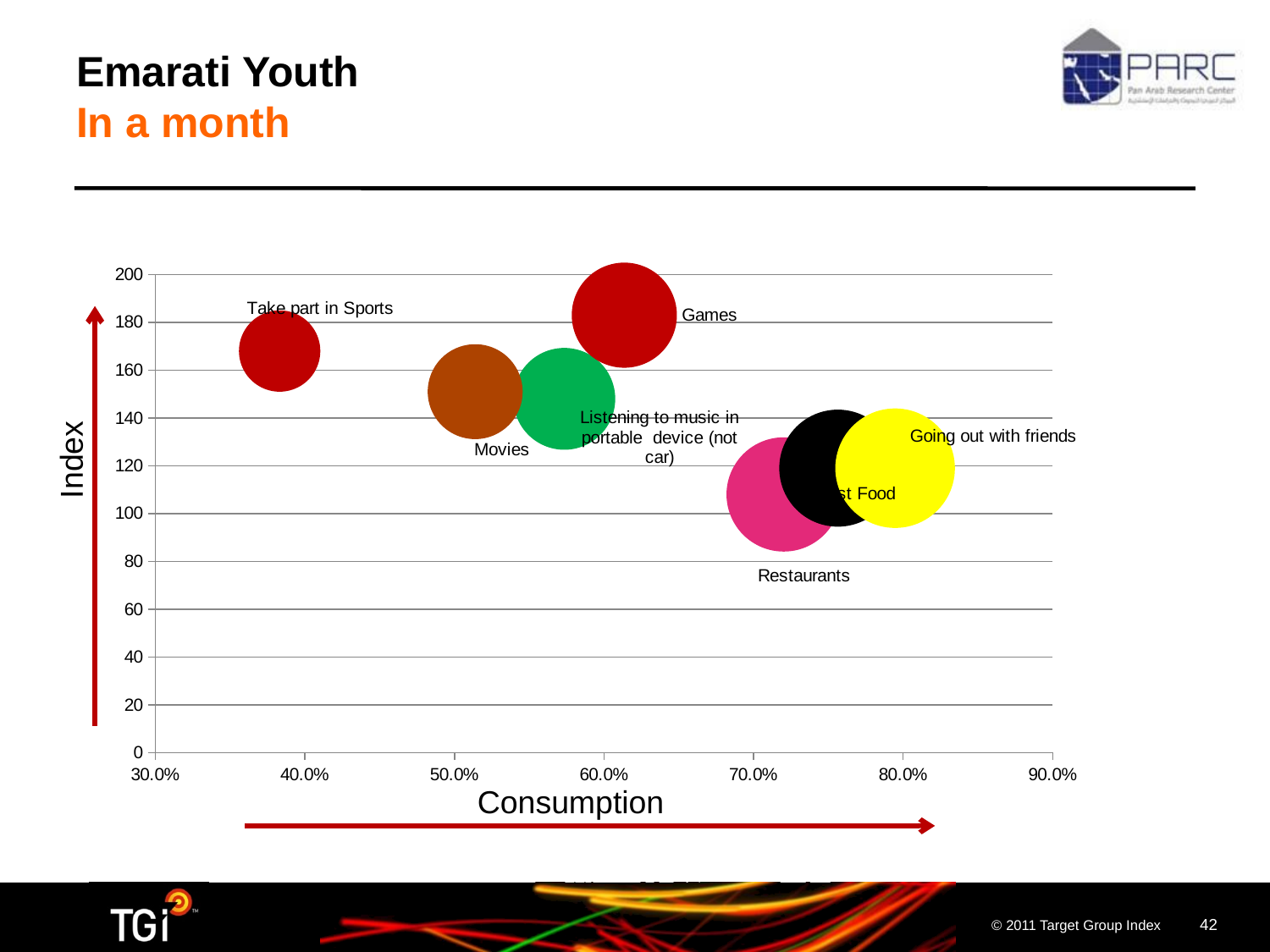
Is the Consumption value for Going out with friends greater or less than 70.0%? greater What is the label of the horizontal axis? Consumption What kind of chart is shown on the slide? bubble chart Is the Index value for Games greater or less than 160? greater Which activity has the lowest Consumption value? Take part in Sports Which activity has the highest Consumption value? Going out with friends Which activity has the highest Index value? Games Is the Index value for Restaurants greater or less than 140? less Which has the higher Index value, Games or Restaurants? Games How many activities (bubbles) are plotted on the chart? 7 What is the label of the vertical axis? Index